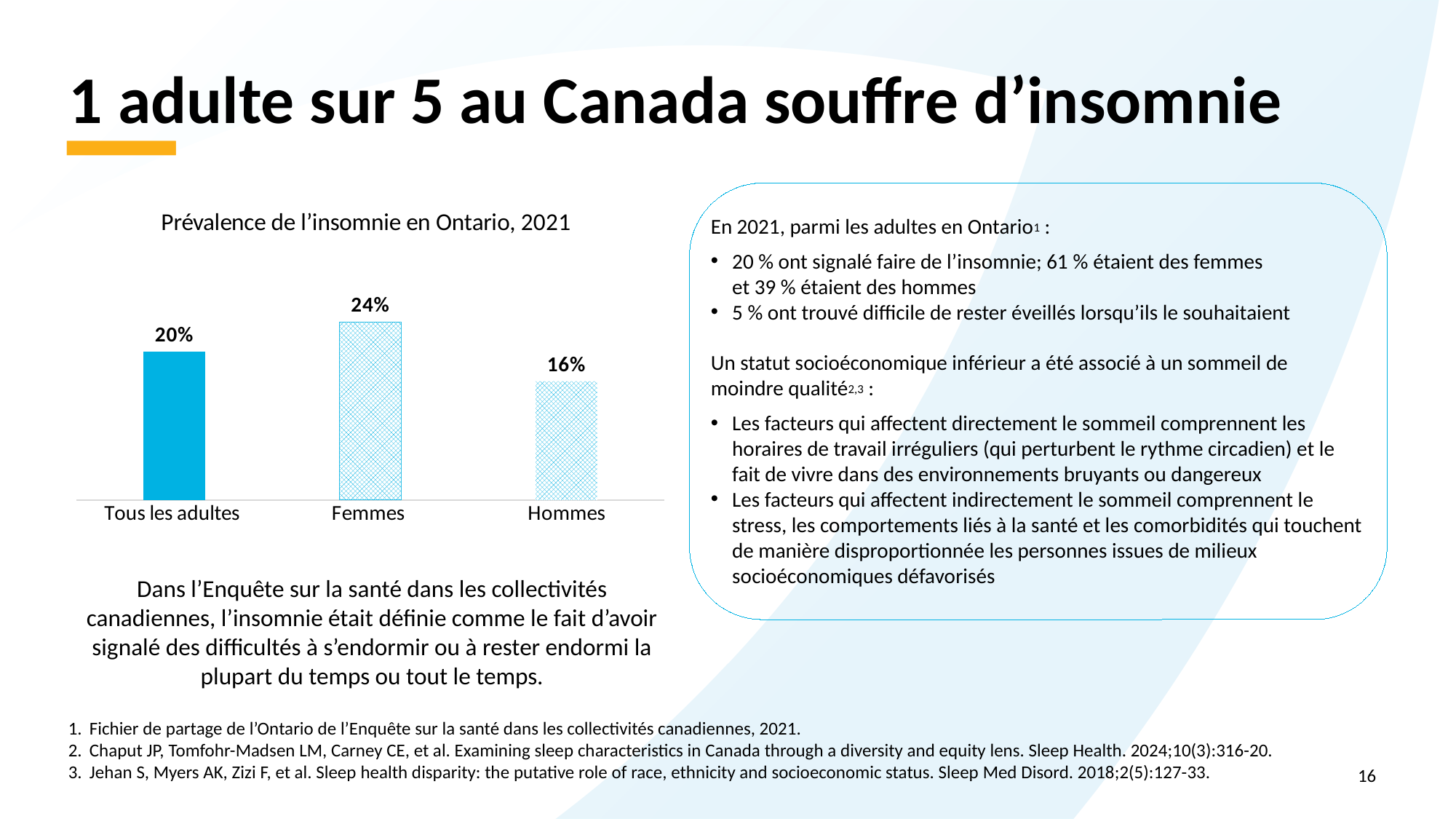
How many categories are shown in the chart? 3 What is the value for Hommes? 16% What kind of chart is shown on the slide? Bar chart Which category has the lowest value? Hommes What is the value for Femmes? 24% Which is larger, the value for Femmes or the value for Hommes? Femmes What is the difference between the values for Femmes and Hommes? 8% What is the title of the chart? Prévalence de l’insomnie en Ontario, 2021 Which bar is drawn with a solid fill rather than a patterned fill? Tous les adultes What is the difference between the values for Femmes and Tous les adultes? 4% What is the value for Tous les adultes? 20% Which category has the highest value? Femmes